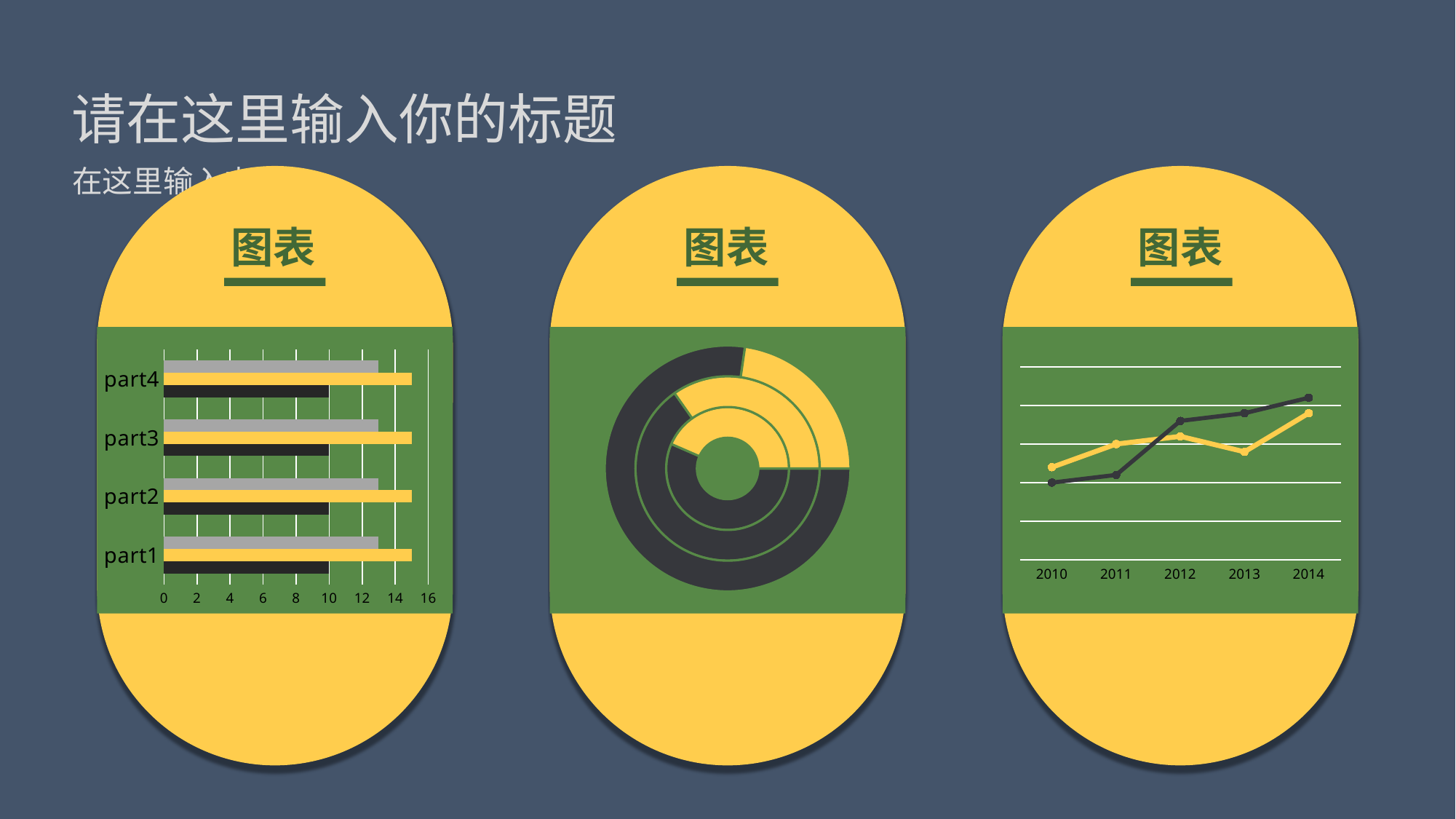
In the left bar chart, is the value of the gray bar for part2 greater or less than 12? greater In the left bar chart, is the value of the yellow bar for part4 greater or less than 14? greater In the left bar chart, which bar is longer for part3, the yellow bar or the black bar? yellow bar In the left bar chart, what is the value of the black bar for part1? 10 What kind of chart is shown in the left capsule? bar chart In the right line chart, which line is higher in 2010, the black line or the yellow line? yellow line In the right line chart, does the black line rise or fall from 2010 to 2014? rise What kind of chart is shown in the right capsule? line chart What kind of chart is shown in the middle capsule? doughnut chart In the right line chart, how many years are shown on the x axis? 5 In the left bar chart, how many categories are shown? 4 In the right line chart, in which year does the black line reach its highest point? 2014